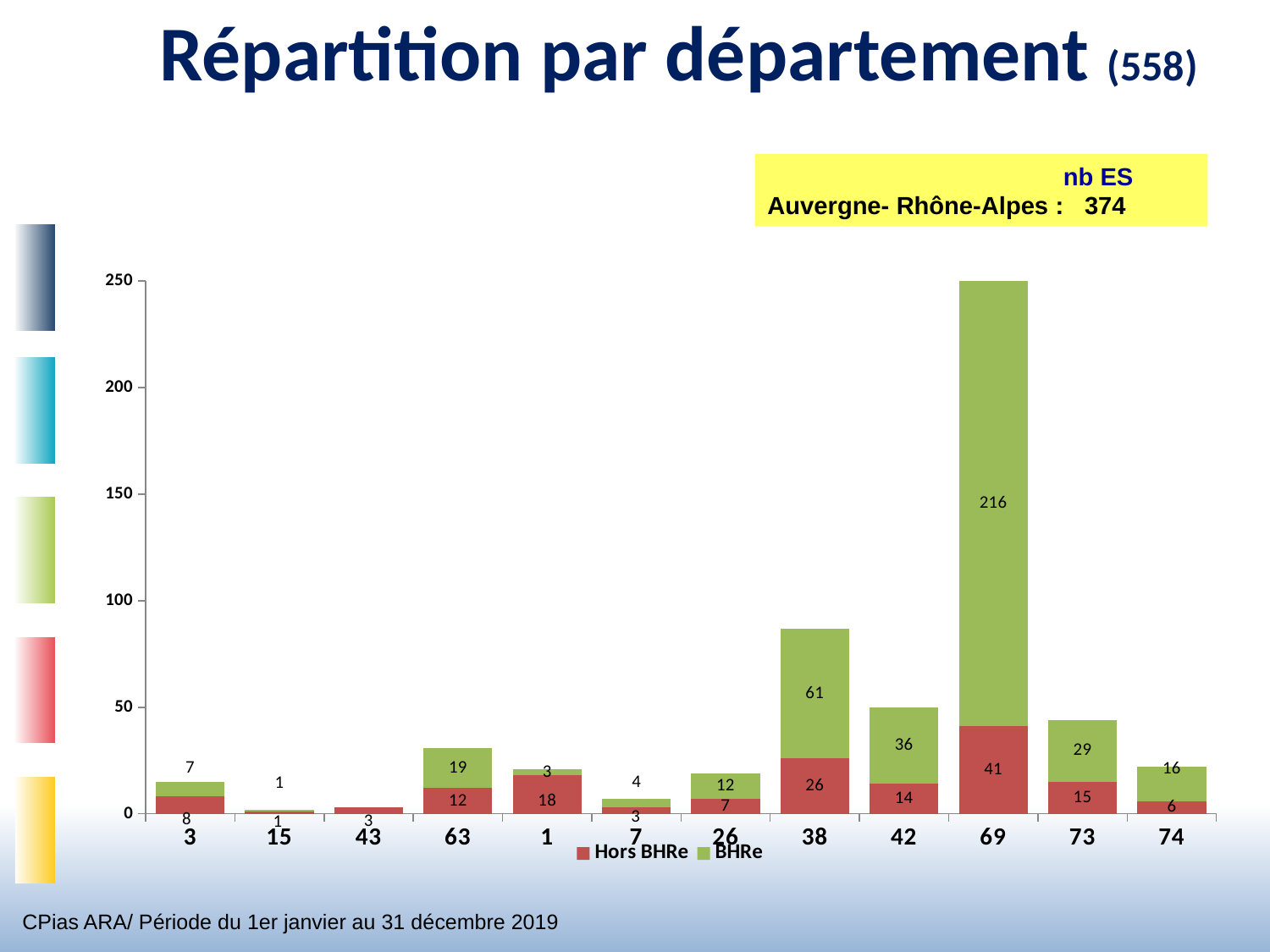
What is the Hors BHRe value for department 38? 26 What is the BHRe value for department 42? 36 What is the total of the stacked bar for department 38? 87 Which is larger, the BHRe value for department 63 or the BHRe value for department 73? department 73 Which department has the lowest Hors BHRe value? 15 What is the Hors BHRe value for department 1? 18 Which department has the highest BHRe value? 69 How many departments are shown on the x axis? 12 What kind of chart is shown on the slide? stacked bar chart What is the difference between the BHRe value for department 69 and the BHRe value for department 38? 155 How many series does the legend list? 2 What is the BHRe value for department 69? 216